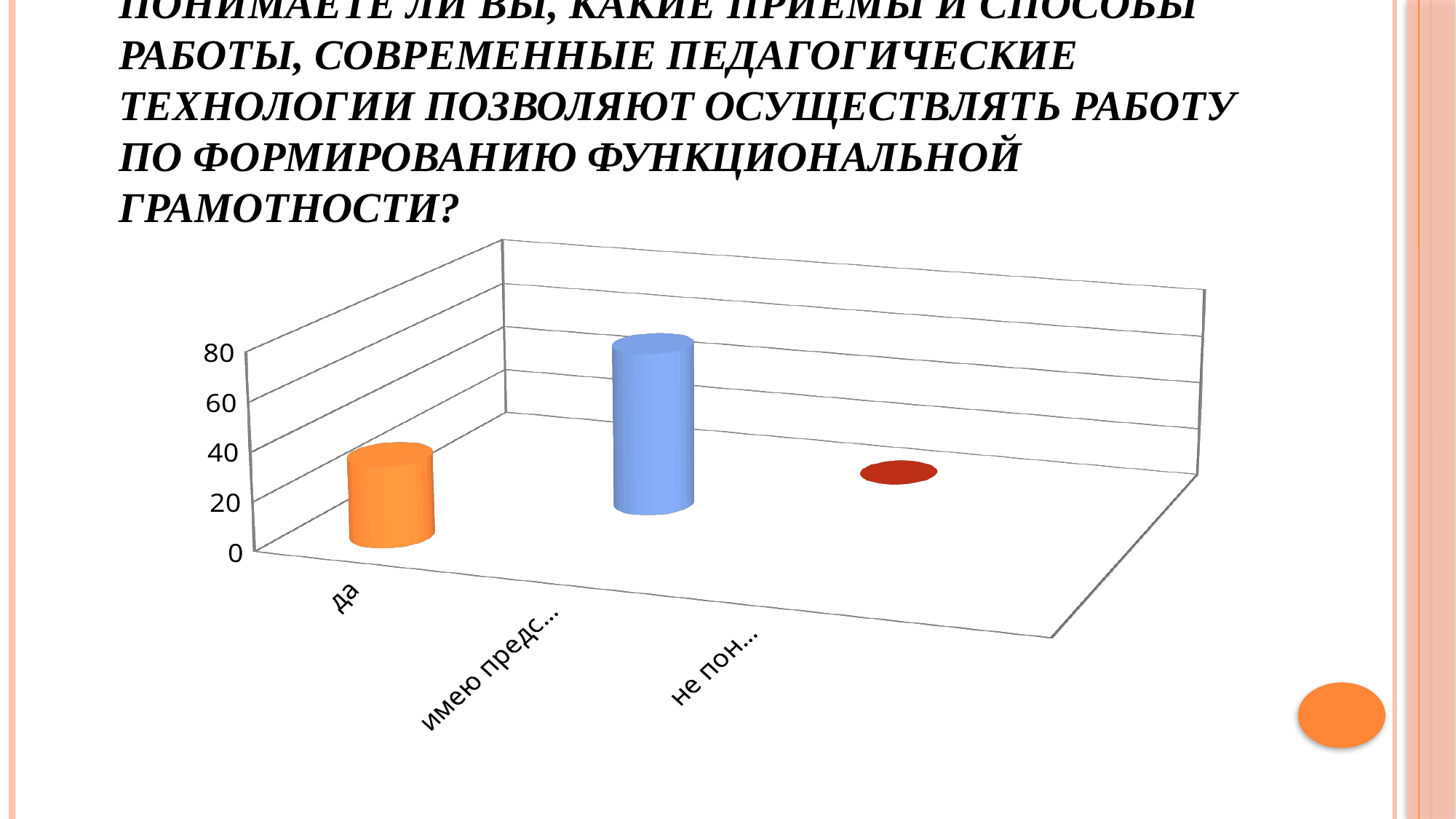
Which category has the lowest bar in the chart? не пон... Which is larger, the value for "да" or the value for "имею предс..."? имею предс... What colour is the bar for the category "да"? orange Which is larger, the value for "да" or the value for "не пон..."? да Is the value for "не пон..." greater or less than 20? less Which category has the highest bar in the chart? имею предс... Is the value for "да" greater or less than 60? less How many categories are shown on the x axis of the chart? 3 Is the value for "имею предс..." greater or less than 40? greater What is the highest tick value shown on the vertical axis of the chart? 80 What kind of chart is shown on the slide? bar chart